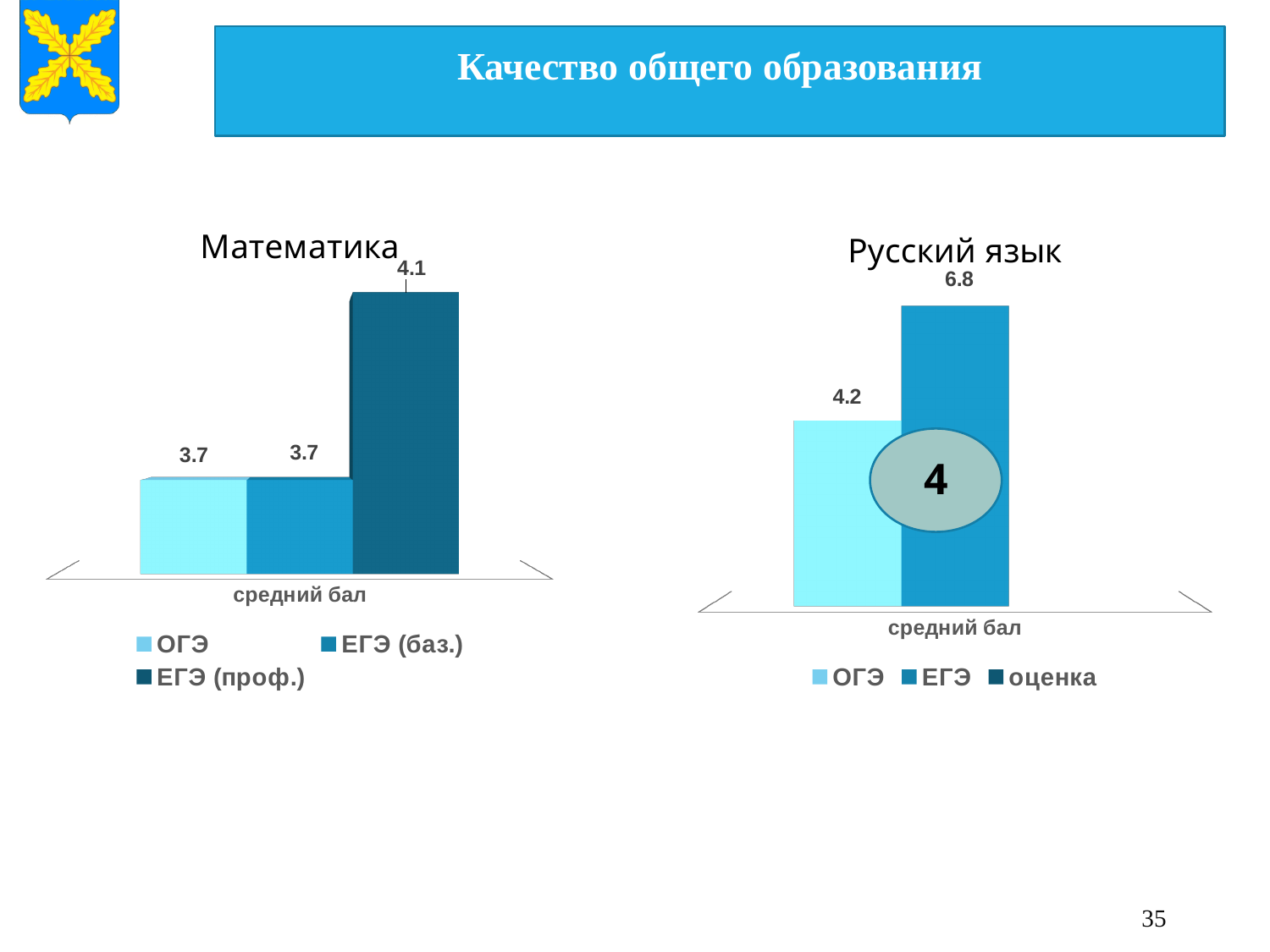
In the Русский язык chart, which is larger, ОГЭ or ЕГЭ? ЕГЭ What type of chart is the Математика chart? Bar chart In the Русский язык chart, what is the value for ОГЭ? 4.2 What is the x-axis category label shown under the bars in the Русский язык chart? средний бал In the Математика chart, what is the value for ОГЭ? 3.7 In the Математика chart, which series has the highest value? ЕГЭ (проф.) In the Русский язык chart, what is the value for ЕГЭ? 6.8 In the Русский язык chart, what is the difference between ЕГЭ and ОГЭ? 2.6 In the Математика chart, how many series does the legend list? 3 In the Математика chart, what is the difference between ЕГЭ (проф.) and ЕГЭ (баз.)? 0.4 In the Русский язык chart, how many series does the legend list? 3 In the Математика chart, what is the value for ЕГЭ (проф.)? 4.1